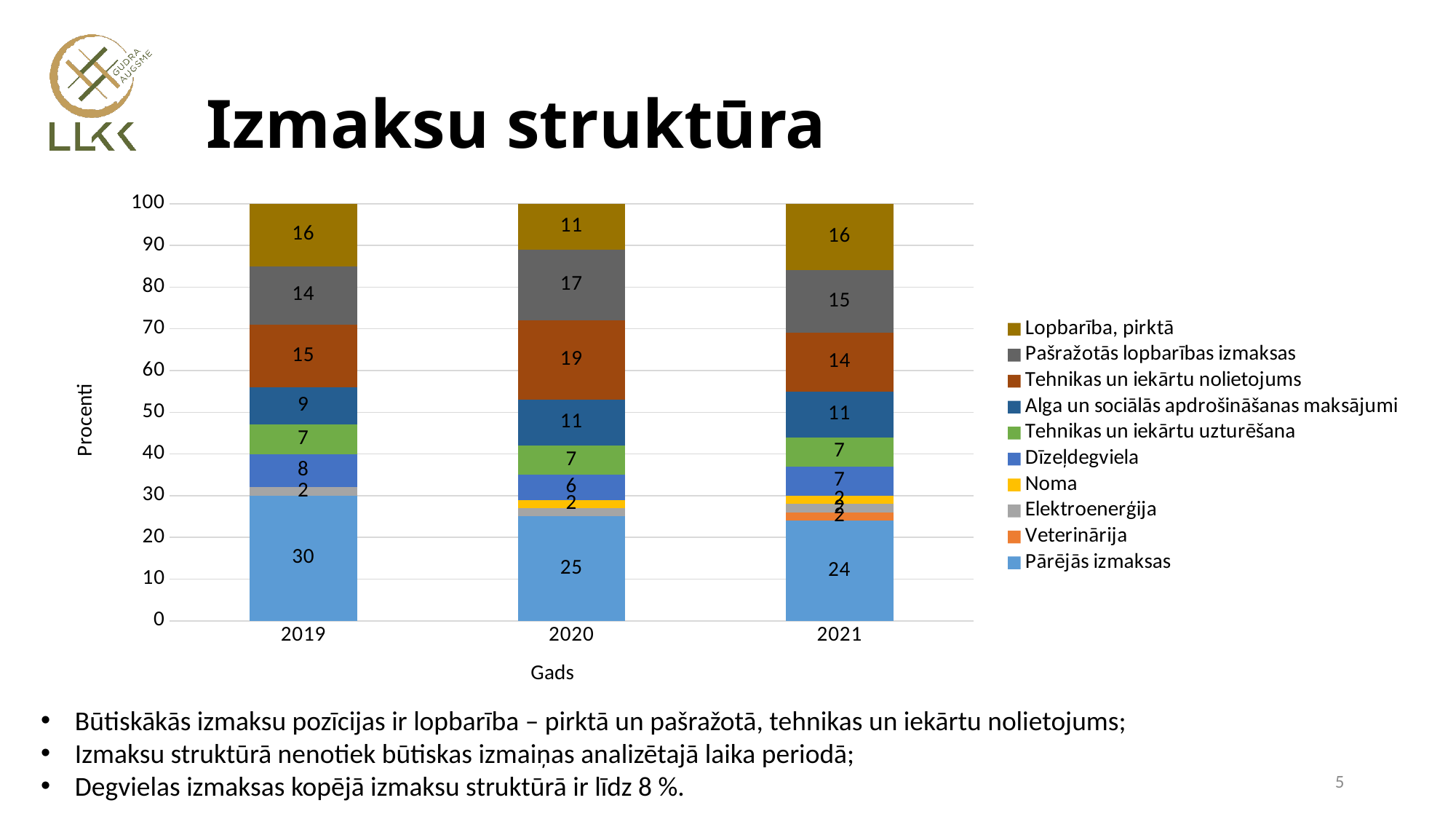
What is the value for Lopbarība, pirktā in 2021? 16 What is the value for Tehnikas un iekārtu nolietojums in 2020? 19 Which year has the larger value for Pašražotās lopbarības izmaksas, 2019 or 2020? 2020 How many series does the legend list? 10 In which year is the value for Lopbarība, pirktā the lowest? 2020 What kind of chart is shown on the slide? Stacked bar chart How many years are shown on the x axis? 3 In which year is the value for Pārējās izmaksas the highest? 2019 Does the value for Pārējās izmaksas rise or fall from 2019 to 2021? Fall What is the value for Dīzeļdegviela in 2020? 6 What is the difference between the Pārējās izmaksas values for 2019 and 2021? 6 What is the value for Pārējās izmaksas in 2019? 30